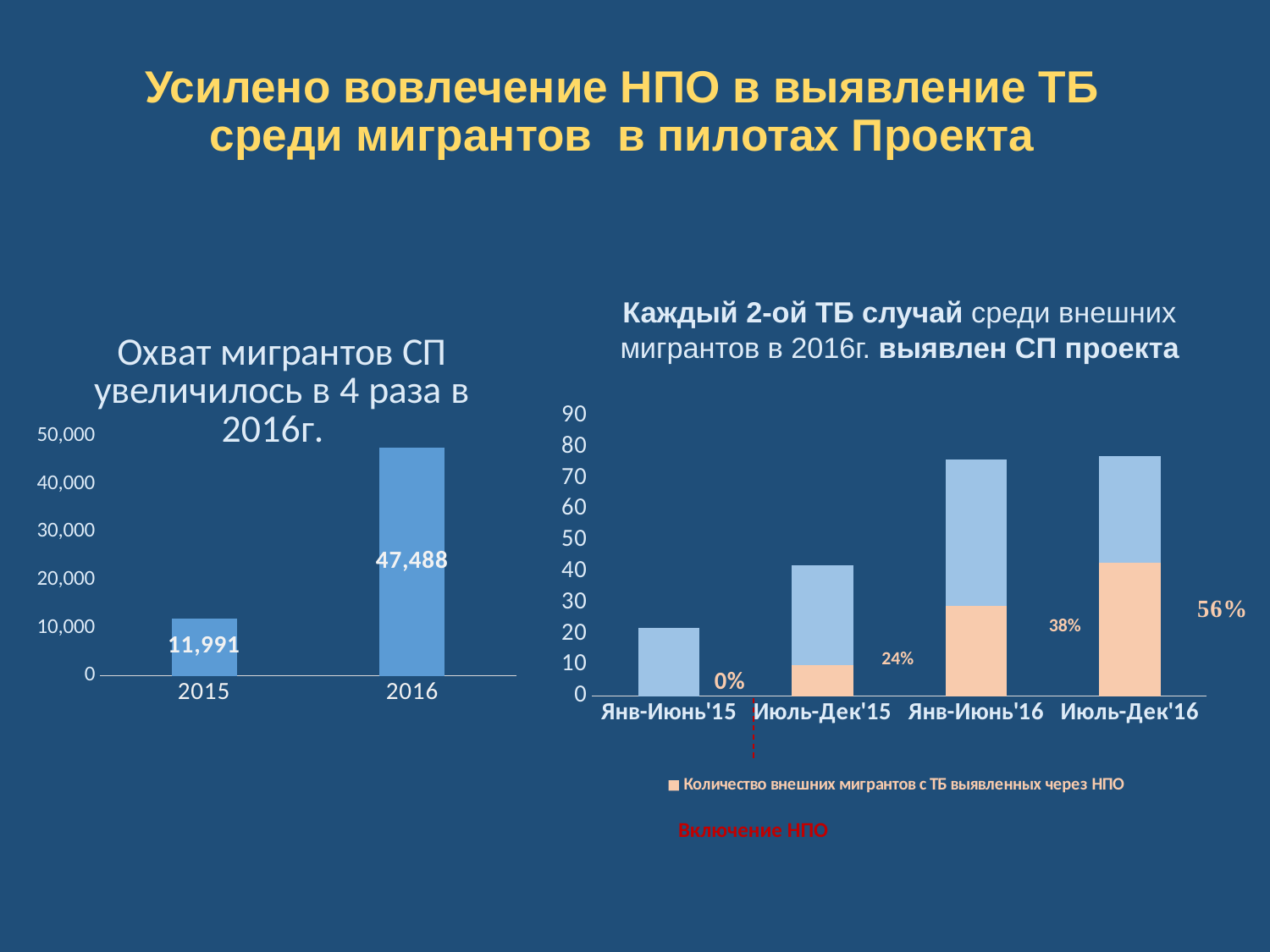
In the left chart (Охват мигрантов СП), how many categories are shown on the x axis? 2 In the right chart (Каждый 2-ой ТБ случай), is the total height of the Янв-Июнь'15 bar greater or less than 30? less In the right chart (Каждый 2-ой ТБ случай), what percentage label is shown for Янв-Июнь'16? 38% In the left chart (Охват мигрантов СП), which year has the larger value, 2015 or 2016? 2016 In the left chart (Охват мигрантов СП), what is the value for 2016? 47,488 In the right chart (Каждый 2-ой ТБ случай), which period has the highest percentage label? Июль-Дек'16 In the right chart (Каждый 2-ой ТБ случай), what percentage label is shown for Июль-Дек'15? 24% In the left chart (Охват мигрантов СП), what is the difference between the 2016 and 2015 values? 35,497 In the right chart (Каждый 2-ой ТБ случай), do the percentage labels rise or fall from Янв-Июнь'15 to Июль-Дек'16? Rise What kind of chart is the left chart (Охват мигрантов СП)? Bar chart In the left chart (Охват мигрантов СП), what is the value for 2015? 11,991 In the right chart (Каждый 2-ой ТБ случай), how many periods are shown on the x axis? 4